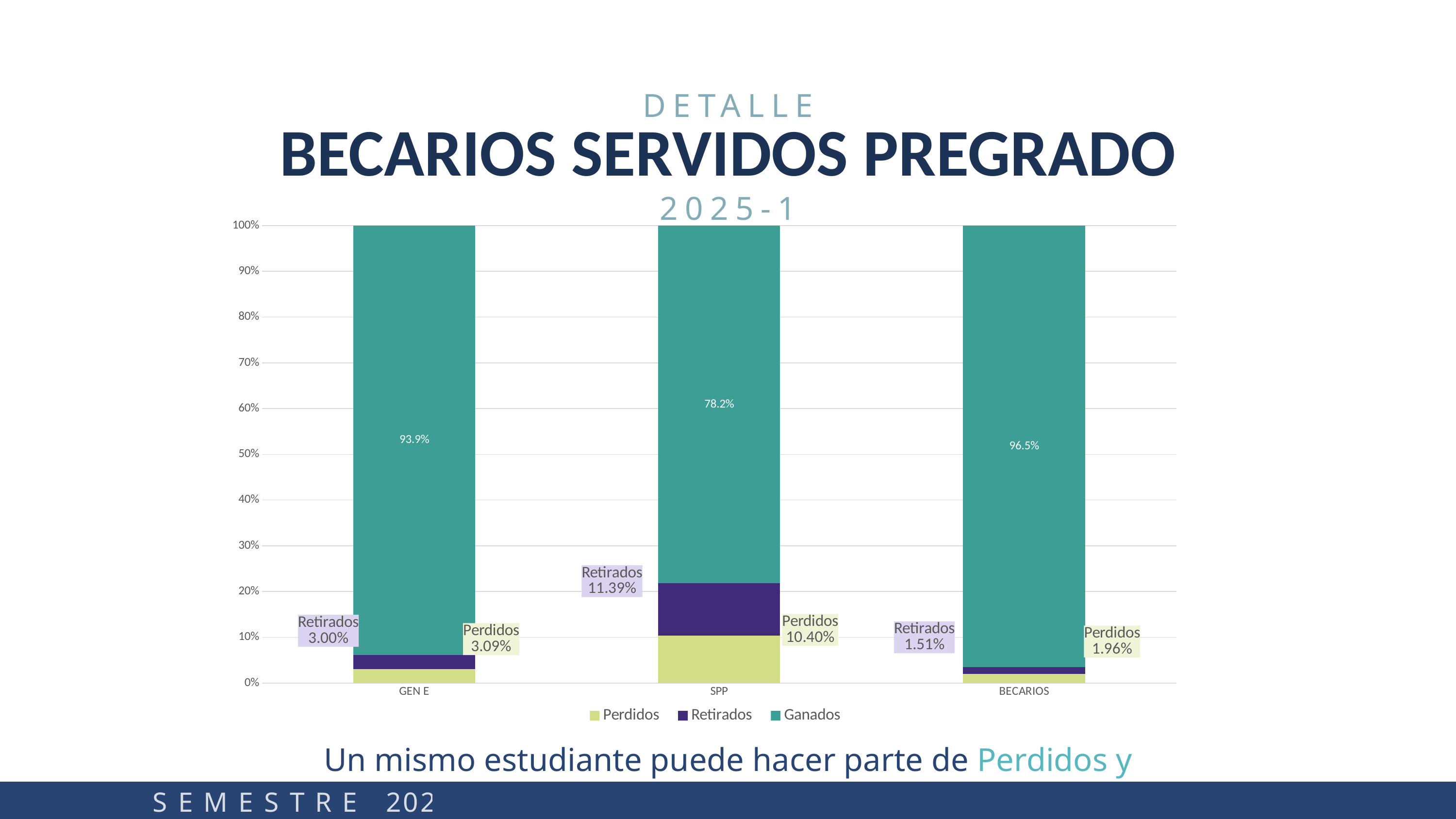
Which category has the lowest Ganados value? SPP How many series does the chart legend list? 3 What is the difference between the Ganados values for BECARIOS and GEN E? 2.6% What kind of chart is shown on the slide? bar chart What is the Ganados value for BECARIOS? 96.5% How many categories are shown on the x axis of the chart? 3 What is the Ganados value for SPP? 78.2% What is the Perdidos value for GEN E? 3.09% Which series is shown in the legend with the dark purple colour? Retirados What is the Retirados value for SPP? 11.39% Which is larger, the Perdidos value for SPP or the Perdidos value for BECARIOS? SPP Which category has the highest Ganados value? BECARIOS